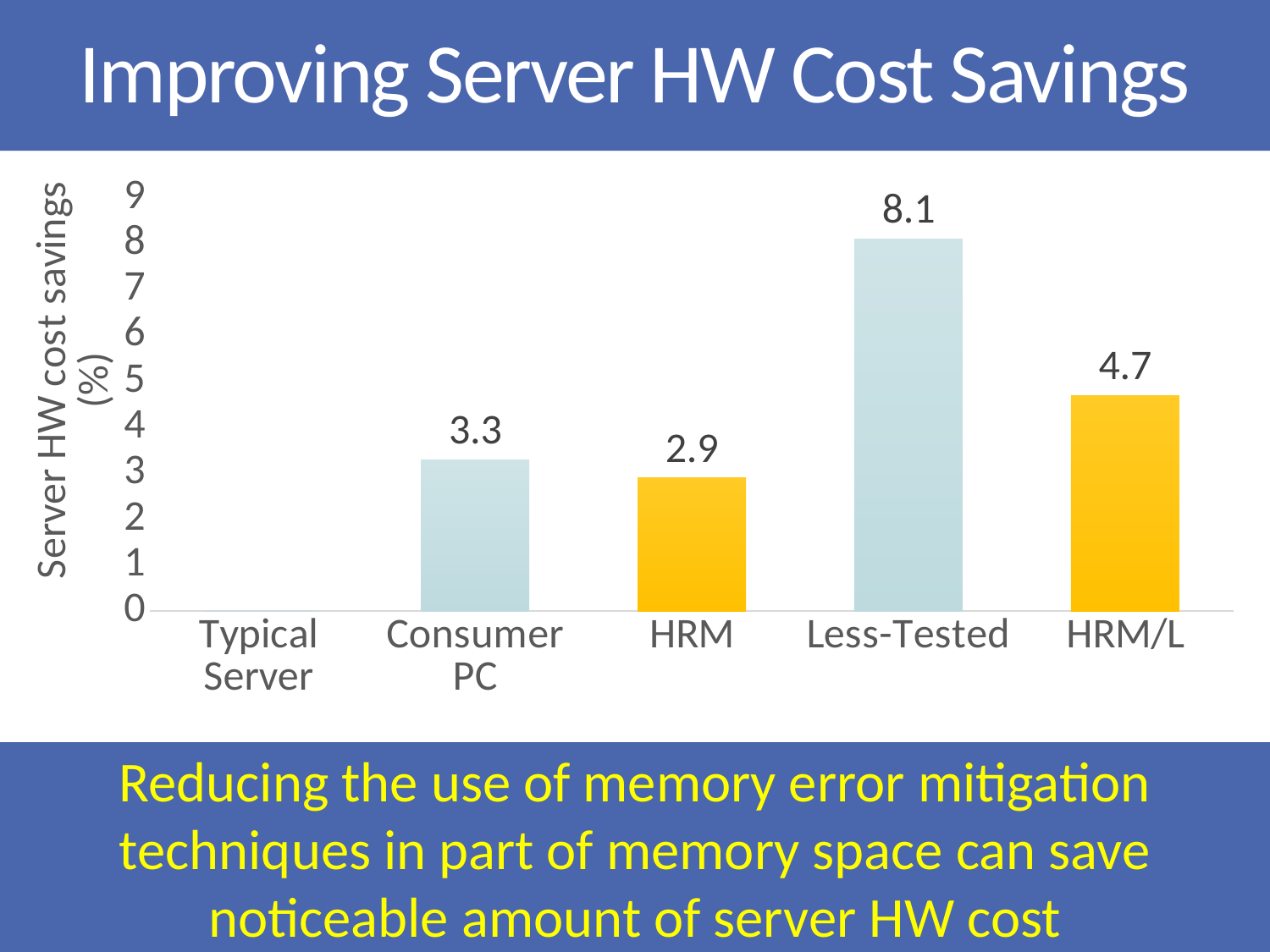
How many categories are shown on the x axis of the chart? 5 What is the server HW cost savings value for HRM/L? 4.7 Which has a larger server HW cost savings value, Consumer PC or HRM? Consumer PC What kind of chart is shown on the slide? bar chart What is the server HW cost savings value for Less-Tested? 8.1 What is the server HW cost savings value for HRM? 2.9 What is the difference in server HW cost savings between Less-Tested and HRM/L? 3.4 Is the value for HRM/L greater or less than 4? greater What is the server HW cost savings value for Consumer PC? 3.3 What is the label of the y axis of the chart? Server HW cost savings (%) Which category has the highest server HW cost savings? Less-Tested Which category has the lowest server HW cost savings? Typical Server